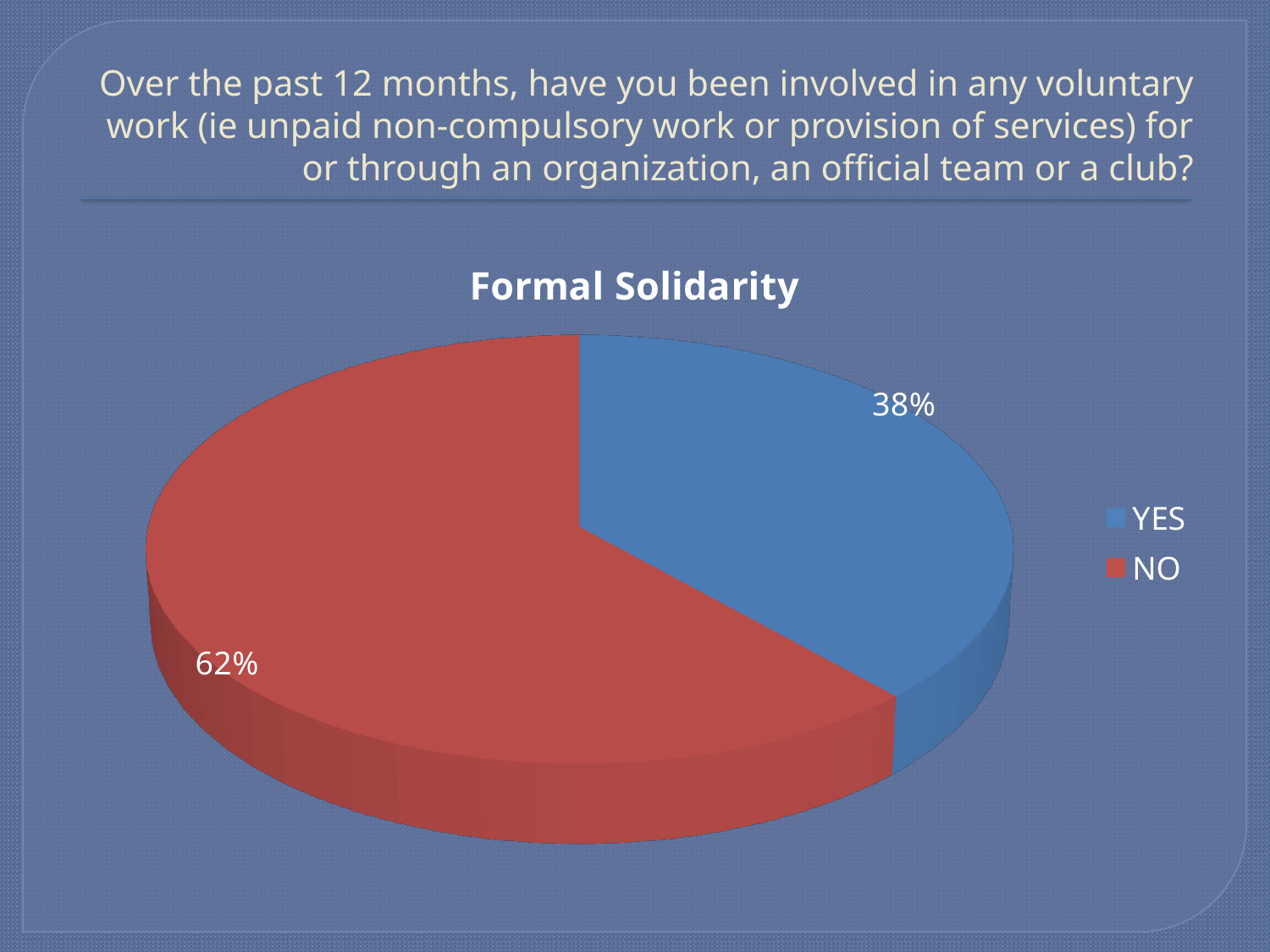
What share of the pie does the YES slice represent? 38% What kind of chart is shown on the slide? Pie chart Which response has the largest share of the pie? NO What is the title of the chart? Formal Solidarity Which response has the smallest share of the pie? YES What is the difference in percentage points between the NO and YES shares? 24 What colour is the NO slice? Red What percentage of respondents answered YES? 38% How many entries does the legend list? 2 Which is larger, the YES share or the NO share? NO How many slices does the pie chart have? 2 What percentage of respondents answered NO? 62%